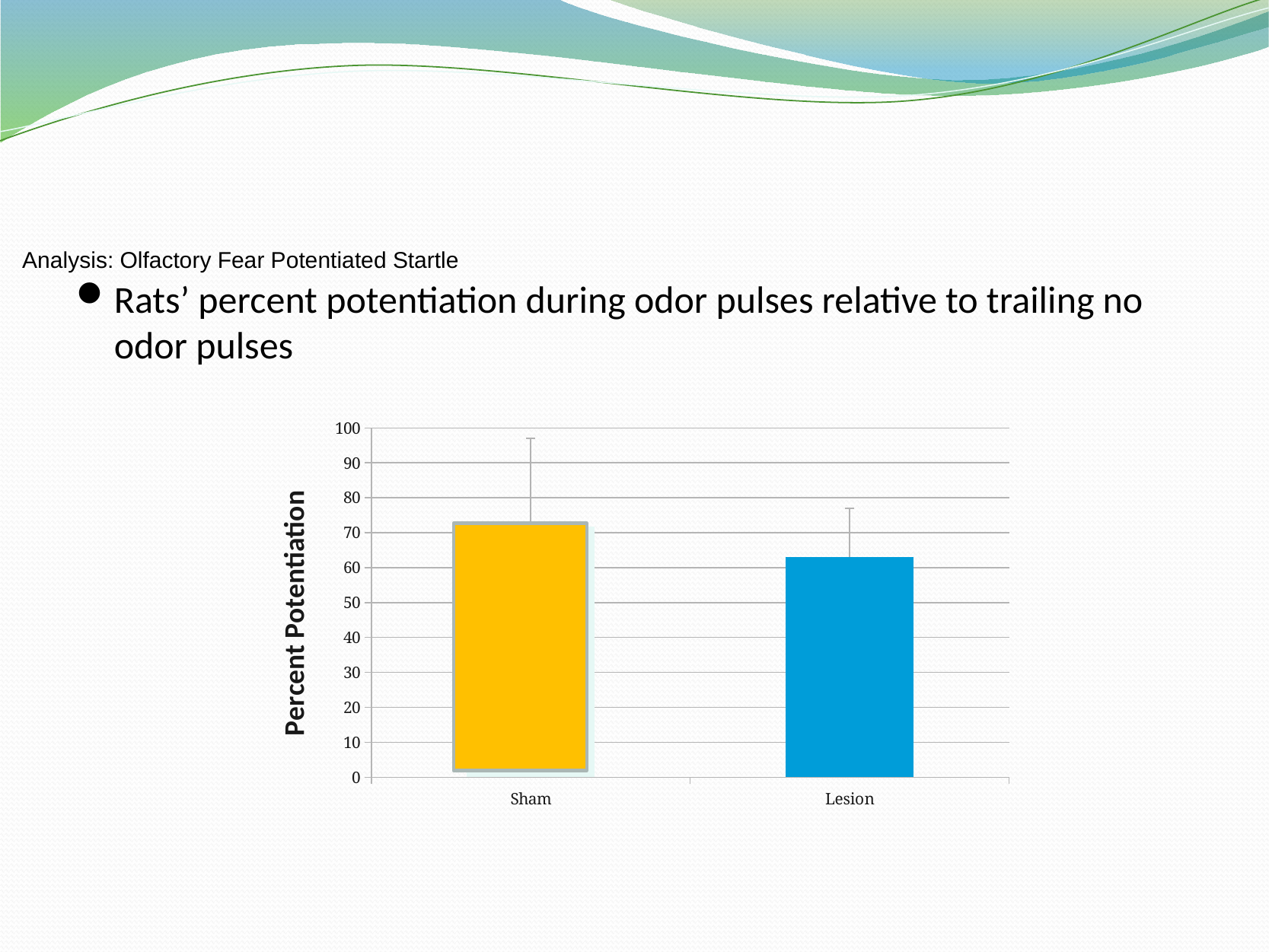
Is the percent potentiation for Lesion greater or less than 60? greater What is the label of the y axis? Percent Potentiation Which category has the highest percent potentiation? Sham What kind of chart is shown on the slide? bar chart What is the maximum value shown on the y axis? 100 Is the percent potentiation for Sham greater or less than 80? less Which category has the lowest percent potentiation? Lesion Is the percent potentiation for Lesion greater or less than 70? less How many categories are shown on the x axis of the chart? 2 Which is larger, the percent potentiation for Sham or for Lesion? Sham What colour is the bar for Lesion? blue